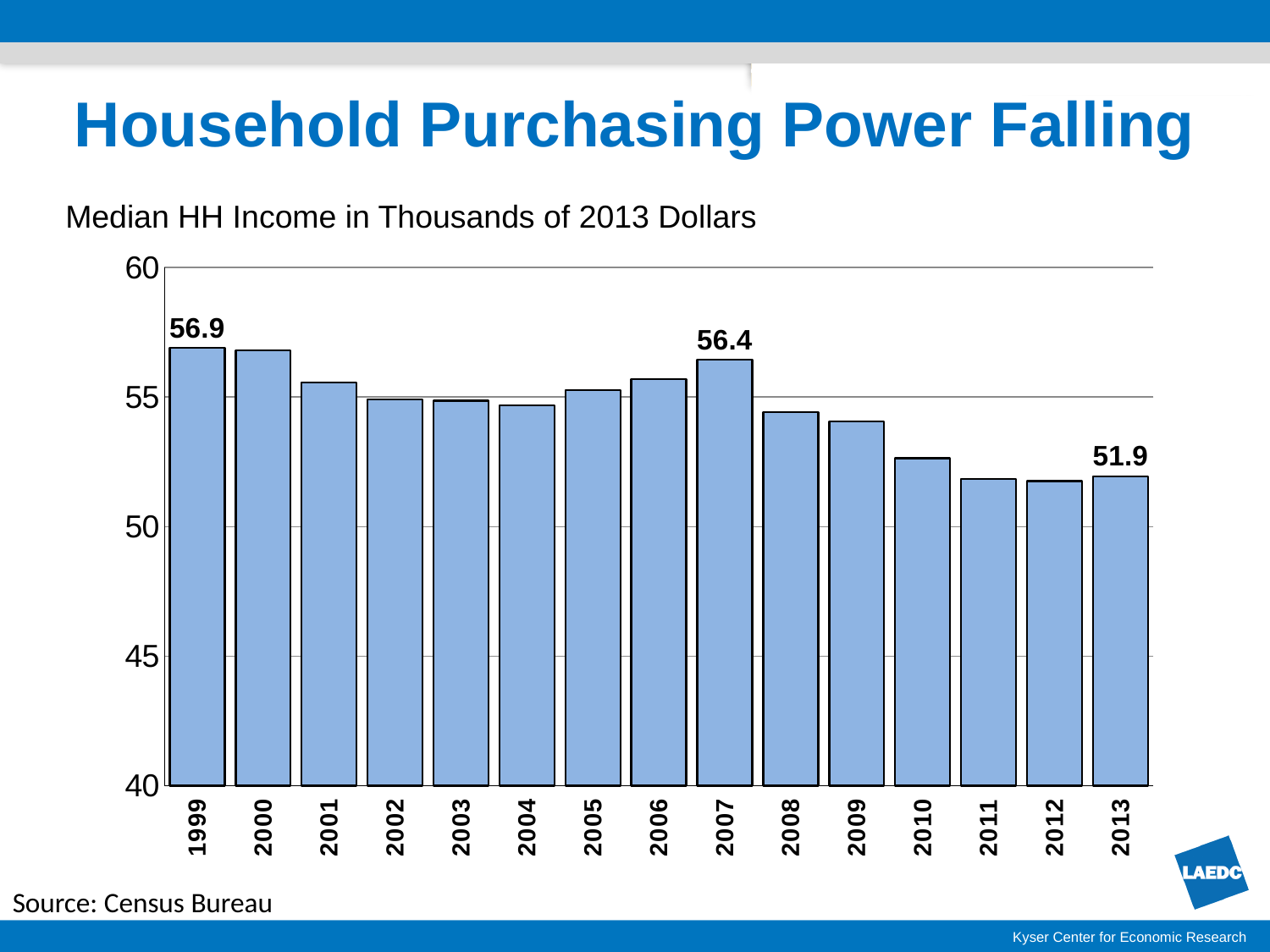
How much higher is the 1999 value than the 2007 value? 0.5 What is the difference between the 1999 value and the 2013 value? 5.0 How many years are shown on the x axis of the chart? 15 Is the value for 2009 greater or less than 55? less Do the values generally rise or fall from 1999 to 2013? fall Which year has the larger value, 1999 or 2013? 1999 Is the value for 2010 greater or less than 55? less What kind of chart is shown on the slide? bar chart What is the median household income value shown for 1999? 56.9 Which year has the larger value, 2007 or 2010? 2007 What is the value shown for 2013? 51.9 What value is labeled on the bar for 2007? 56.4